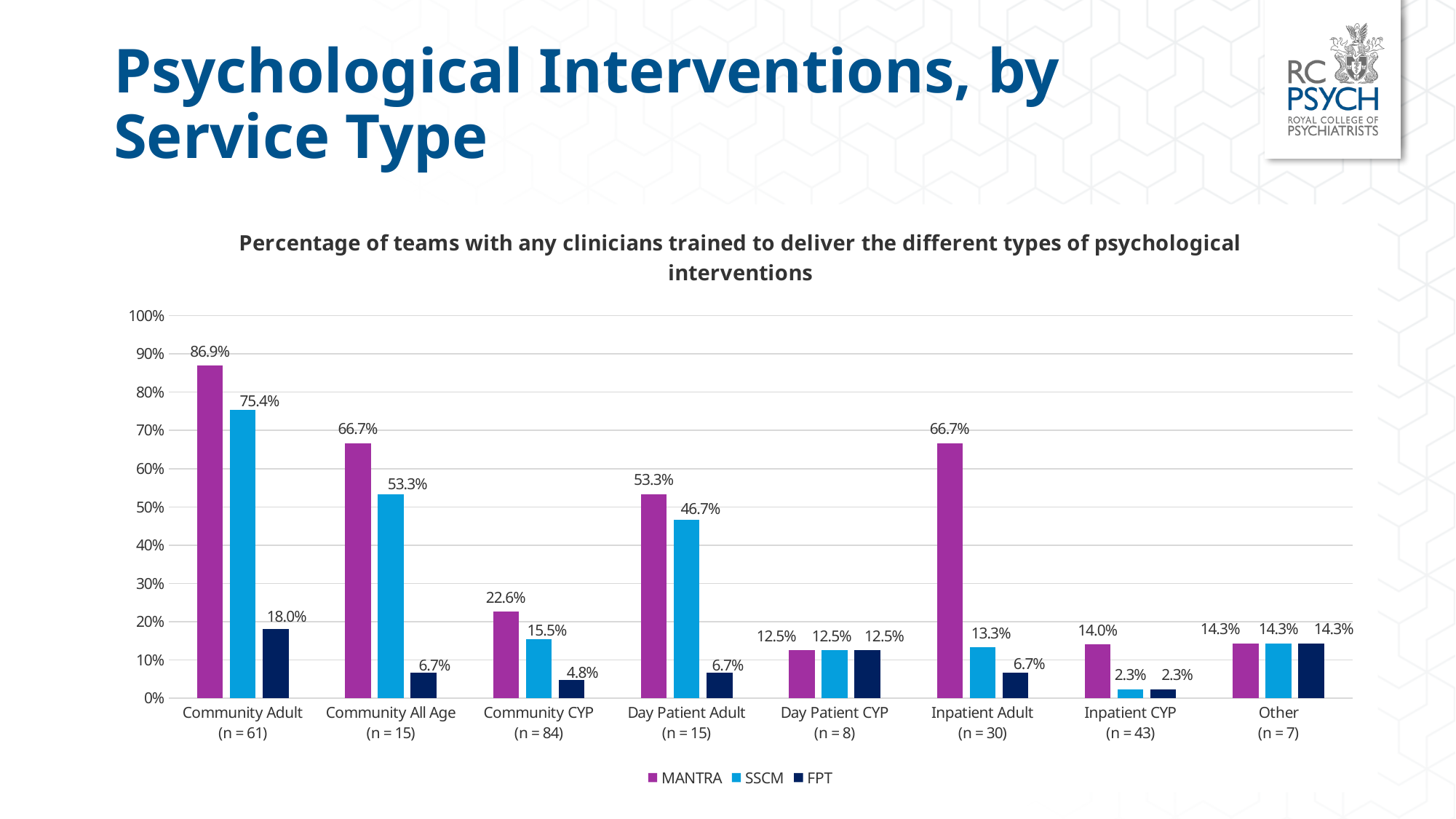
Which service type has the highest MANTRA value? Community Adult (n = 61) What is the title of the chart? Percentage of teams with any clinicians trained to deliver the different types of psychological interventions What is the SSCM value for Day Patient Adult (n = 15)? 46.7% What kind of chart is shown on the slide? bar chart Is the FPT value for Community Adult (n = 61) greater or less than 10%? greater How many series does the legend list? 3 Which is larger for Inpatient Adult (n = 30): the MANTRA value or the SSCM value? MANTRA What is the FPT value for Community CYP (n = 84)? 4.8% How many service type categories are shown on the x axis? 8 What is the MANTRA value for Community Adult (n = 61)? 86.9% Which service type has the lowest SSCM value? Inpatient CYP (n = 43) What is the difference between the MANTRA and SSCM values for Community Adult (n = 61)? 11.5%